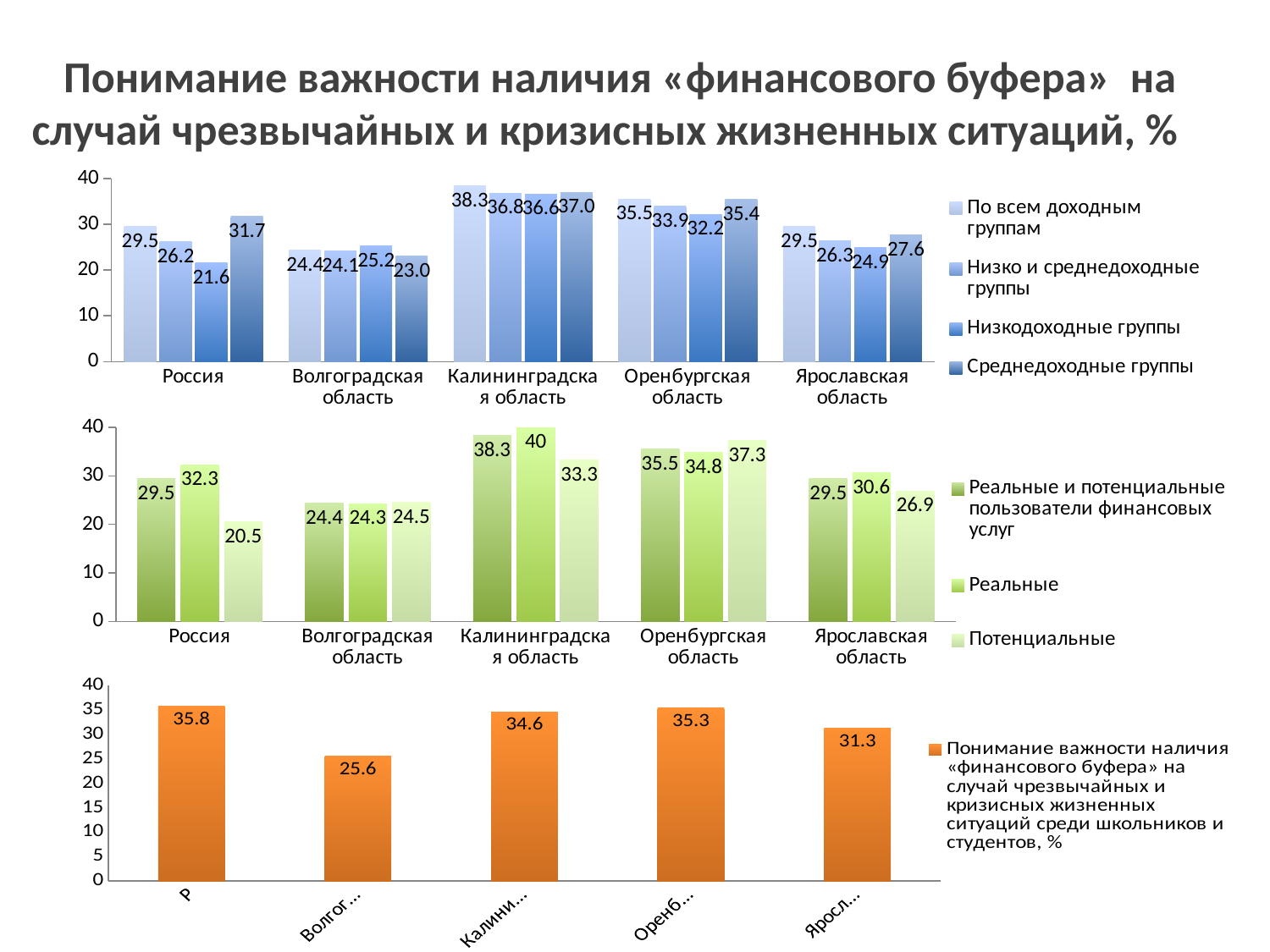
What kind of chart is the bottom chart? Bar chart In the top chart, which region has the highest value in the series 'Среднедоходные группы'? Калининградская область In the top chart, how many series does the legend list? 4 In the top chart, what is the value for Россия in the series 'Низкодоходные группы'? 21.6 In the top chart, what is the value for Калининградская область in the series 'По всем доходным группам'? 38.3 In the middle chart, which is larger for Оренбургская область: 'Реальные' or 'Потенциальные'? Потенциальные In the middle chart, which region has the lowest value in the series 'Потенциальные'? Россия In the bottom chart, what is the value of the second bar from the left? 25.6 In the bottom chart, what is the value of the first bar from the left? 35.8 In the middle chart, what is the value for Калининградская область in the series 'Реальные'? 40 In the middle chart, how many regions are shown on the x axis? 5 In the top chart, what is the difference between the 'Среднедоходные группы' and 'Низкодоходные группы' values for Россия? 10.1